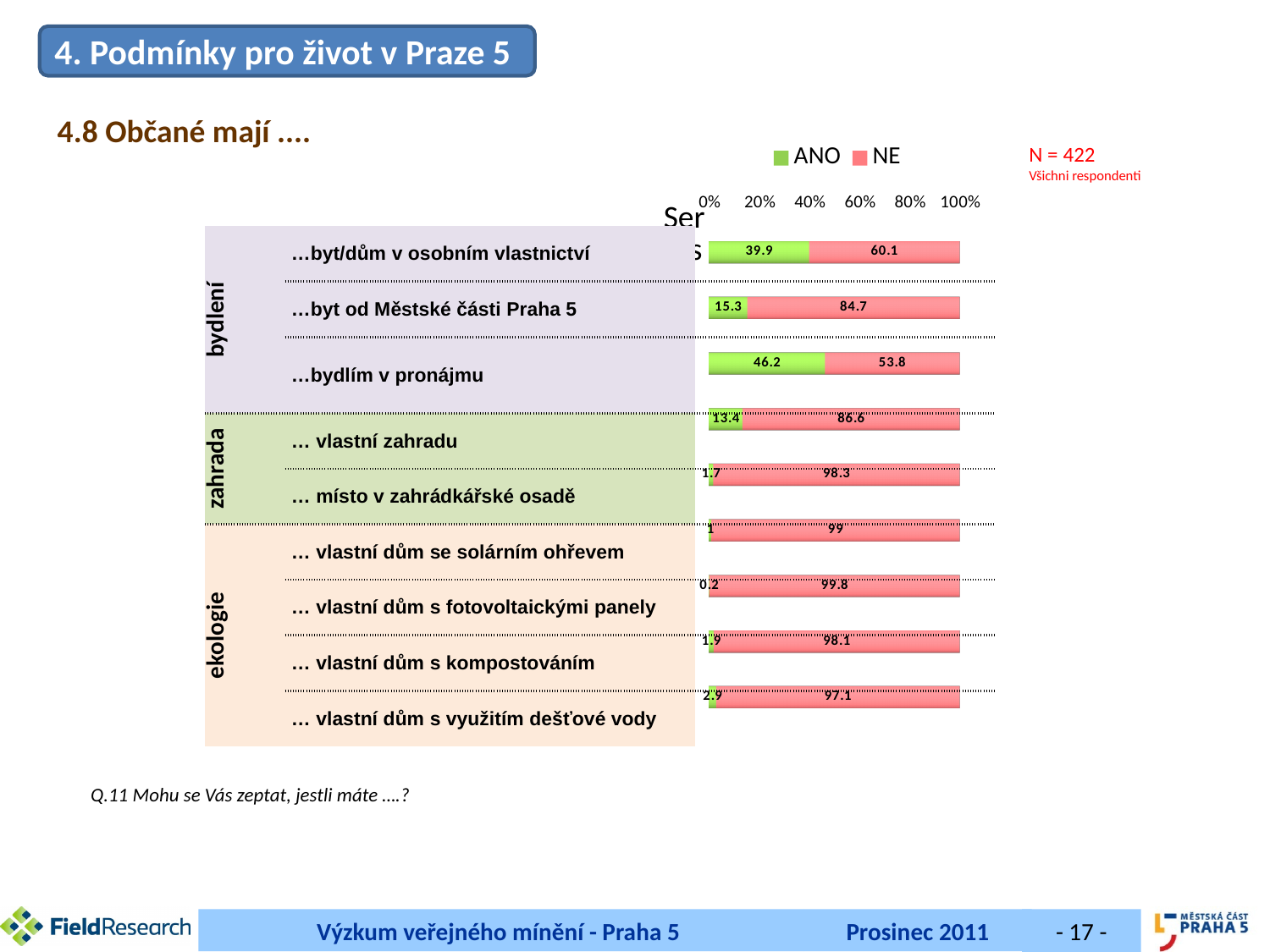
What is the NE value for '…byt od Městské části Praha 5'? 84.7 What is the NE value for '… vlastní dům s fotovoltaickými panely'? 99.8 How many series does the chart legend list? 2 What type of chart is shown on the slide? bar chart What is the ANO value for '…bydlím v pronájmu'? 46.2 Which is larger: the ANO value for '…byt/dům v osobním vlastnictví' or the ANO value for '…byt od Městské části Praha 5'? …byt/dům v osobním vlastnictví What is the difference between the NE value and the ANO value for '…byt/dům v osobním vlastnictví'? 20.2 How many categories (bars) are shown in the chart? 9 What is the ANO value for '… vlastní zahradu'? 13.4 What are the two series named in the legend? ANO and NE Which category has the highest ANO value? …bydlím v pronájmu Which category has the lowest ANO value? … vlastní dům s fotovoltaickými panely